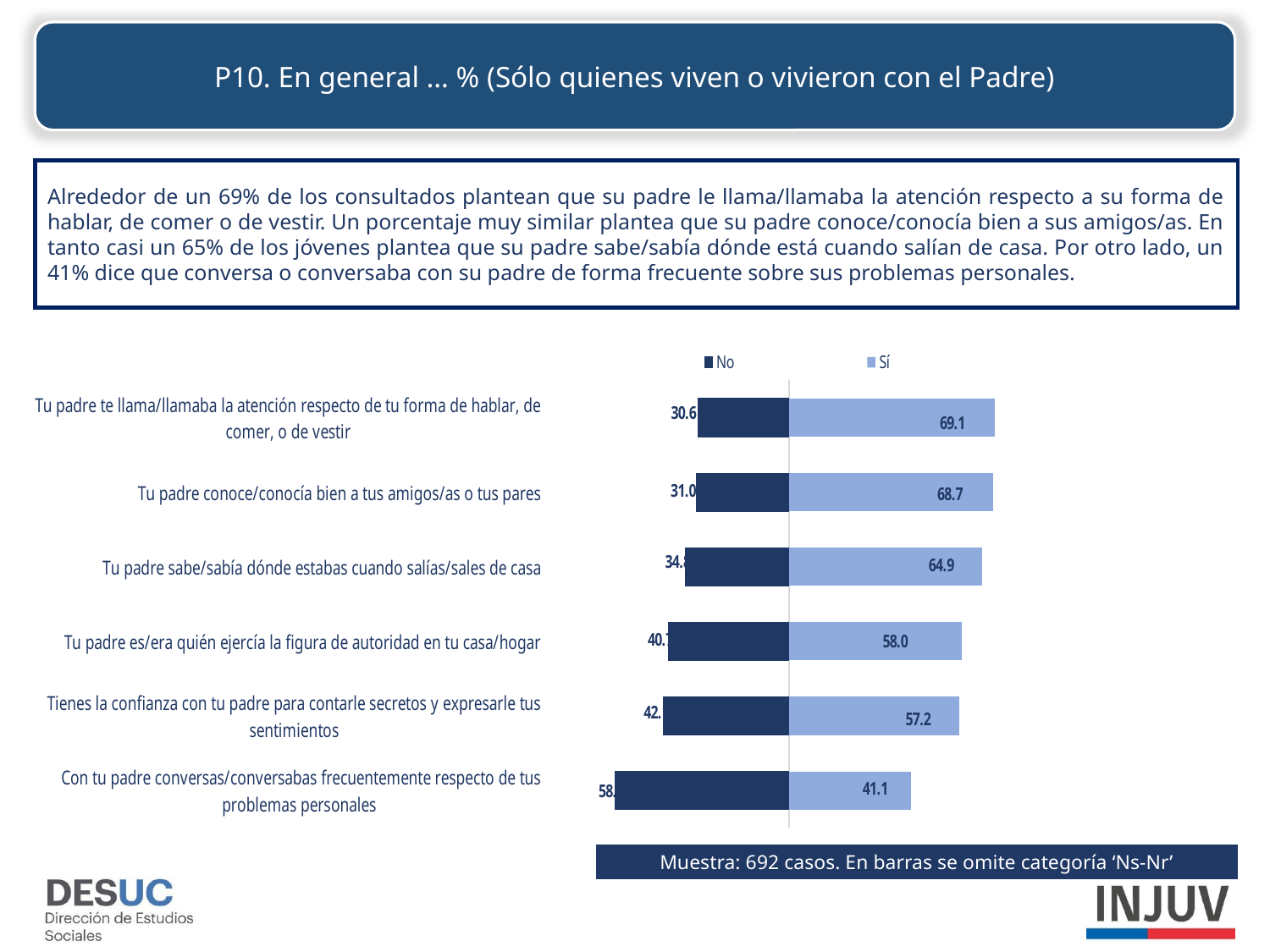
How many series does the legend list? 2 What is the difference between the 'Sí' values for 'Tu padre sabe/sabía dónde estabas cuando salías/sales de casa' and 'Con tu padre conversas/conversabas frecuentemente respecto de tus problemas personales'? 23.8 What is the 'Sí' value for 'Con tu padre conversas/conversabas frecuentemente respecto de tus problemas personales'? 41.1 Which category has the highest 'Sí' value? Tu padre te llama/llamaba la atención respecto de tu forma de hablar, de comer, o de vestir What is the 'Sí' value for 'Tu padre es/era quién ejercía la figura de autoridad en tu casa/hogar'? 58.0 What kind of chart is shown on the slide? Bar chart How many categories are shown in the chart? 6 Which is larger: the 'Sí' value for 'Tu padre es/era quién ejercía la figura de autoridad en tu casa/hogar' or for 'Tienes la confianza con tu padre para contarle secretos y expresarle tus sentimientos'? Tu padre es/era quién ejercía la figura de autoridad en tu casa/hogar What are the two series named in the legend? No and Sí Which category has the lowest 'Sí' value? Con tu padre conversas/conversabas frecuentemente respecto de tus problemas personales What is the 'No' value for 'Tu padre conoce/conocía bien a tus amigos/as o tus pares'? 31.0 What is the 'Sí' value for 'Tu padre te llama/llamaba la atención respecto de tu forma de hablar, de comer, o de vestir'? 69.1